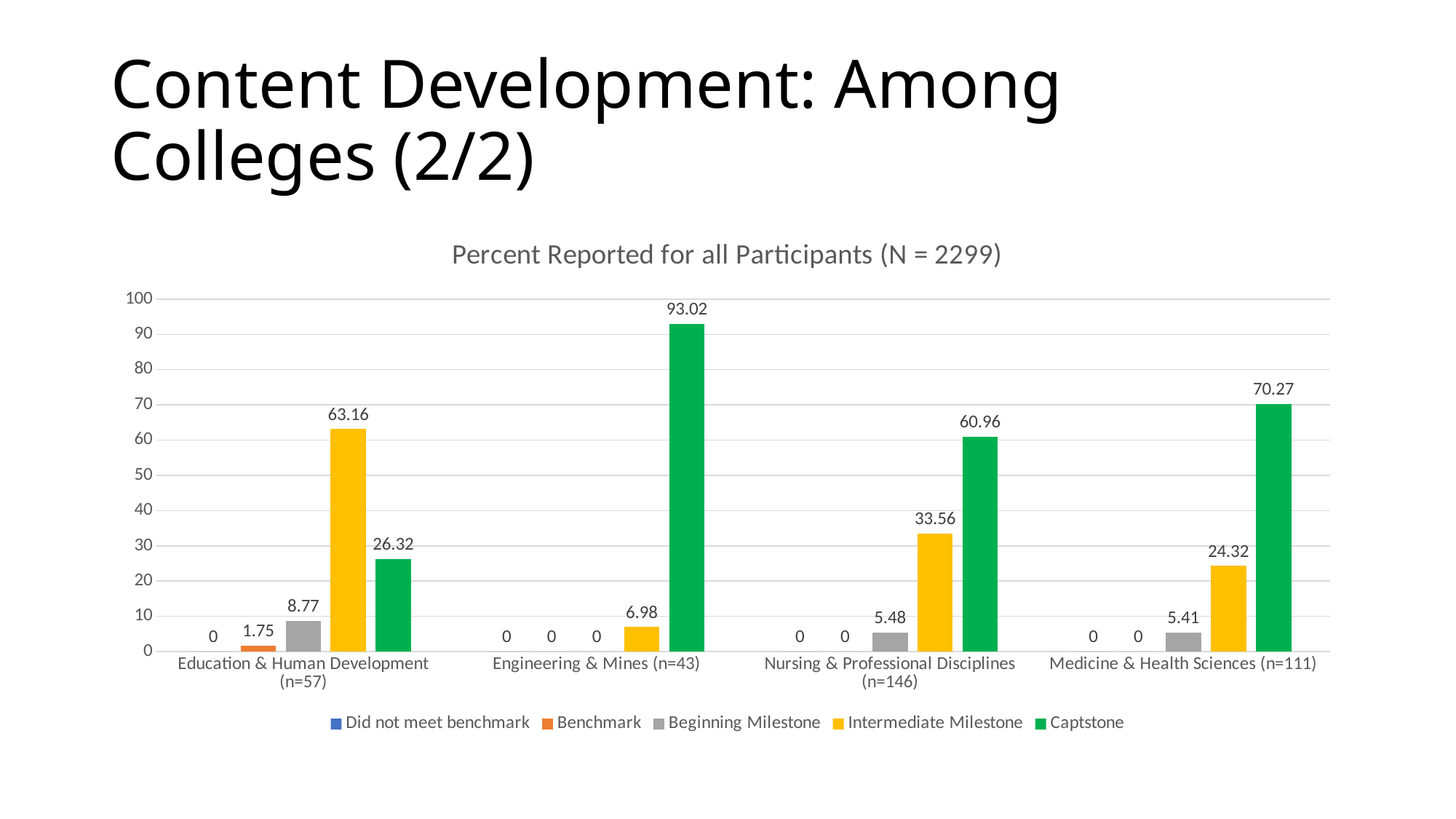
How many series does the legend list? 5 What is the Benchmark value for Education & Human Development (n=57)? 1.75 What is the difference between the Captstone and Intermediate Milestone values for Medicine & Health Sciences (n=111)? 45.95 What is the Captstone value for Engineering & Mines (n=43)? 93.02 Which college has the highest Captstone value? Engineering & Mines (n=43) How many colleges are shown on the x axis? 4 Which college has the lowest Intermediate Milestone value? Engineering & Mines (n=43) What is the title of the chart? Percent Reported for all Participants (N = 2299) What is the Intermediate Milestone value for Education & Human Development (n=57)? 63.16 What kind of chart is shown on the slide? Bar chart Which is larger for Nursing & Professional Disciplines (n=146): the Captstone value or the Intermediate Milestone value? Captstone What is the Beginning Milestone value for Nursing & Professional Disciplines (n=146)? 5.48